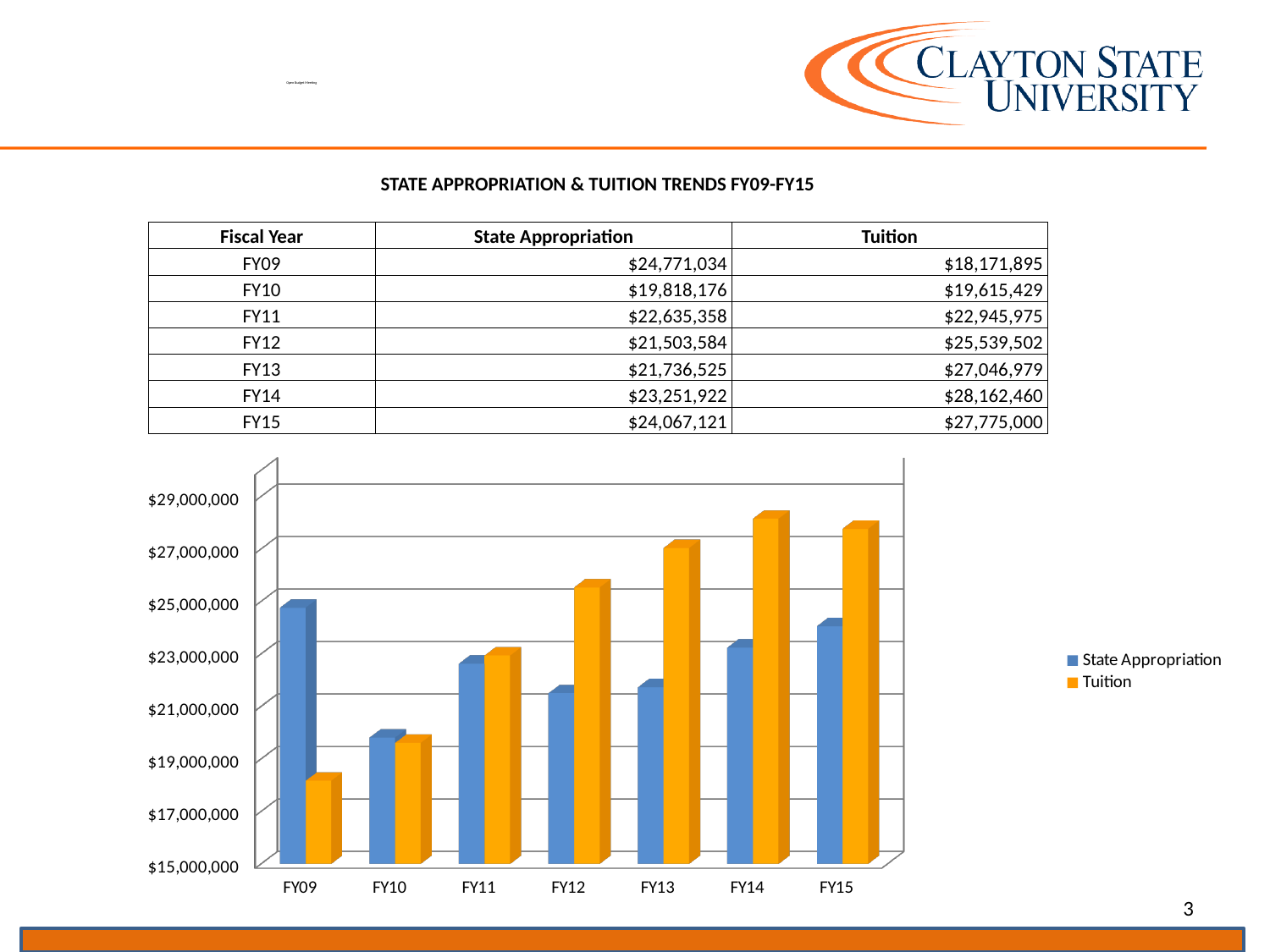
How many fiscal years are shown on the x axis of the chart? 7 In FY12, which is larger: State Appropriation or Tuition? Tuition What is the Tuition value for FY15? $27,775,000 What is the Tuition value for FY14? $28,162,460 What is the State Appropriation value for FY09? $24,771,034 How many series does the chart legend list? 2 Is the State Appropriation value for FY15 greater or less than $23,000,000? greater Does the Tuition value rise or fall from FY09 to FY14? Rise What kind of chart is shown on the slide? Bar chart Which fiscal year has the lowest State Appropriation value? FY10 Which fiscal year has the highest Tuition value? FY14 What is the difference between State Appropriation and Tuition in FY09? $6,599,139